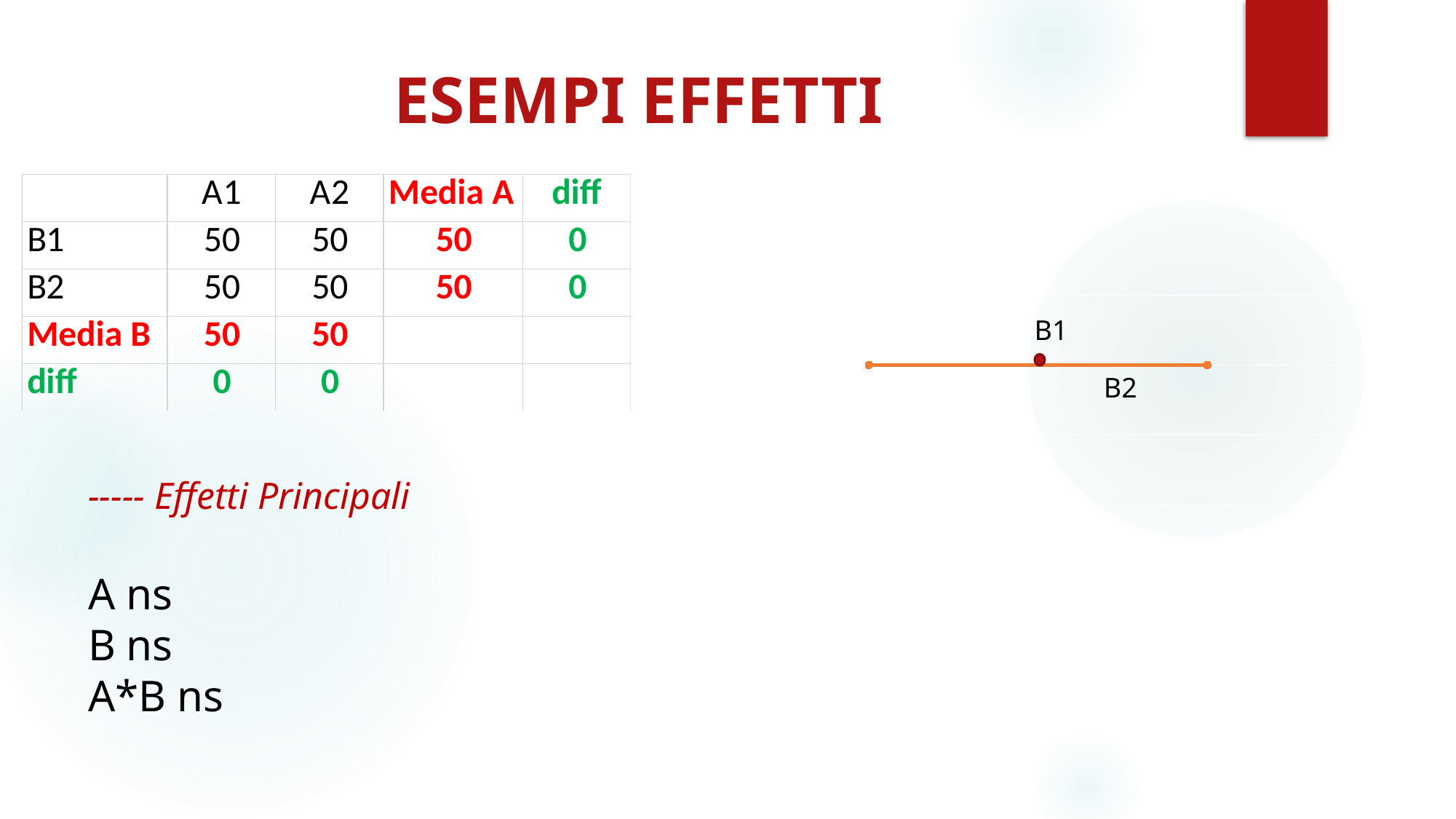
What kind of chart is shown on the right side of the slide? line chart How many series are labelled on the chart on the right? 2 Does the B2 line on the chart rise, fall, or stay flat from left to right? stay flat Which series label is placed above the line on the chart? B1 Does the B1 line on the chart rise, fall, or stay flat from left to right? stay flat Do the B1 and B2 lines on the chart overlap or are they separated? overlap What are the labels of the two series shown on the chart? B1 and B2